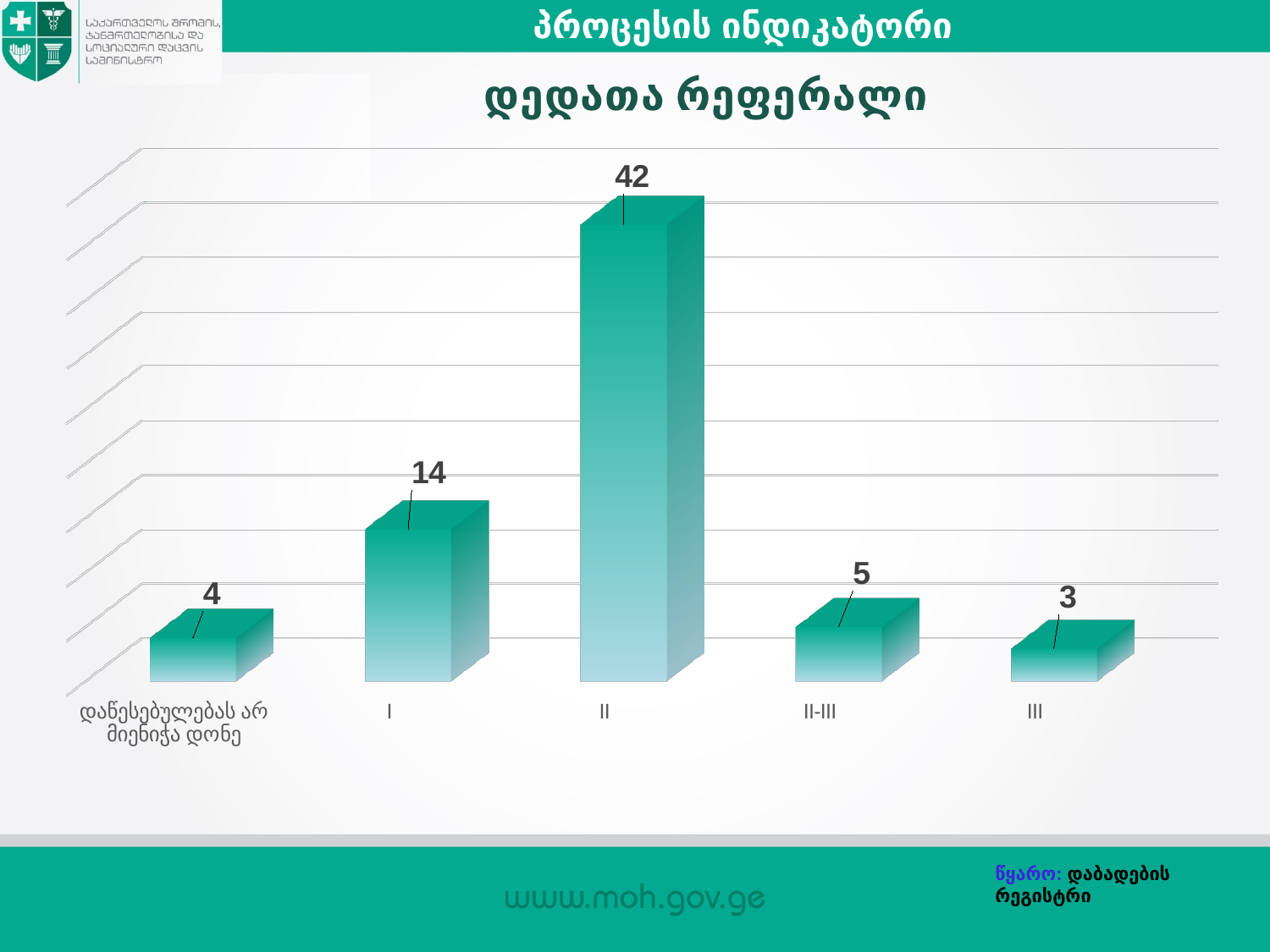
Which is larger, the value for category I or the value for category II-III? I Which category has the highest value? II What is the value for category II? 42 What kind of chart is shown on the slide? Bar chart What is the title of the chart? დედათა რეფერალი What is the difference between the values for category II and category I? 28 What is the value for category I? 14 What is the value for category II-III? 5 How many categories are shown on the chart? 5 Which category has the lowest value? III What is the value for the category 'დაწესებულებას არ მიენიჭა დონე'? 4 What is the value for category III? 3